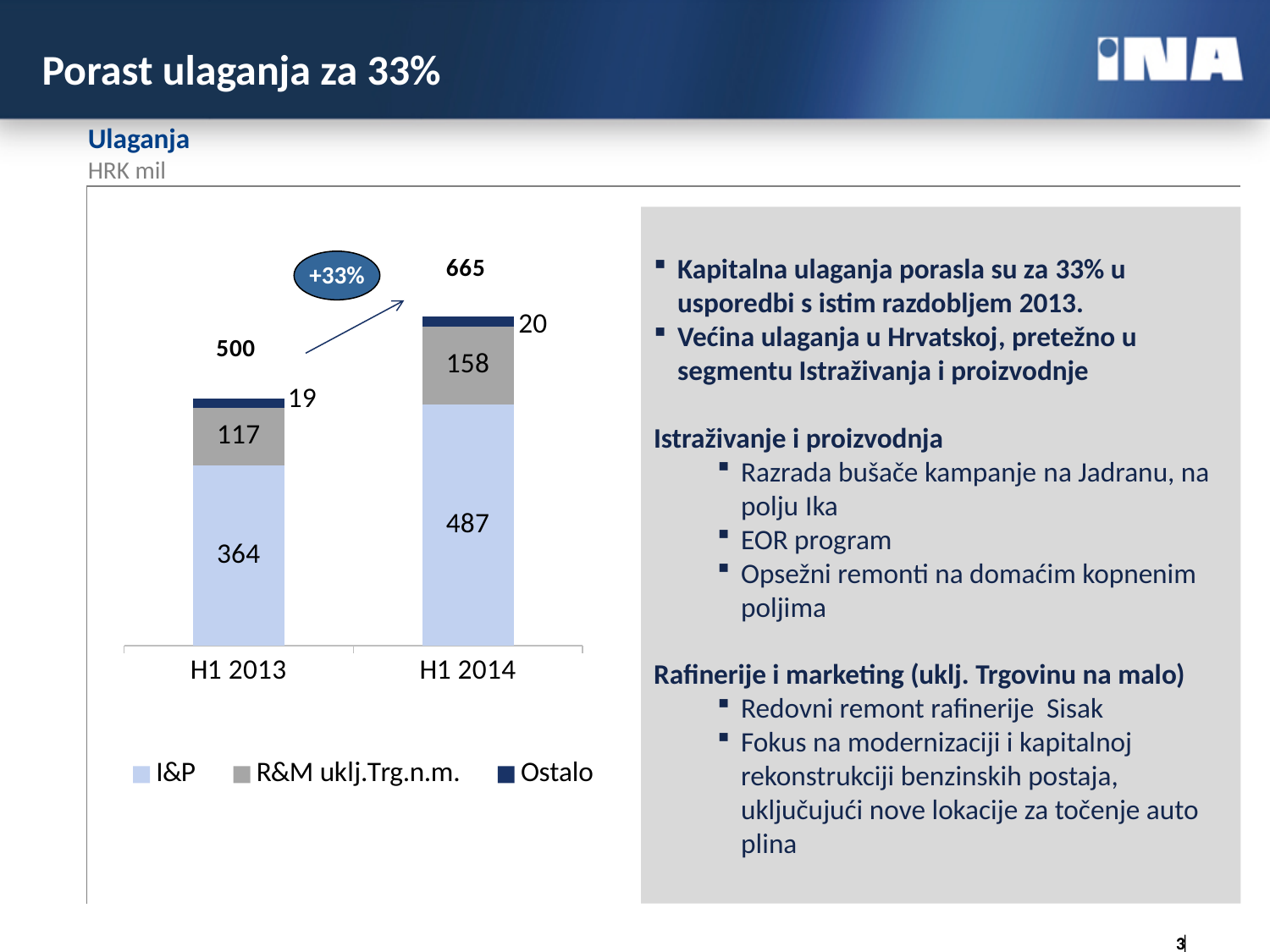
What is the difference between the I&P values for H1 2014 and H1 2013? 123 What percentage increase is shown in the oval annotation on the chart? +33% What is the Ostalo value for H1 2014? 20 What kind of chart is shown on the slide? Stacked bar chart What is the difference between the R&M uklj.Trg.n.m. values for H1 2014 and H1 2013? 41 How many categories are shown on the x axis? 2 What is the I&P value for H1 2014? 487 Which period has the larger total investment, H1 2013 or H1 2014? H1 2014 What is the R&M uklj.Trg.n.m. value for H1 2013? 117 What is the total of the stacked bar for H1 2014? 665 How many series does the legend list? 3 What is the total of the stacked bar for H1 2013? 500